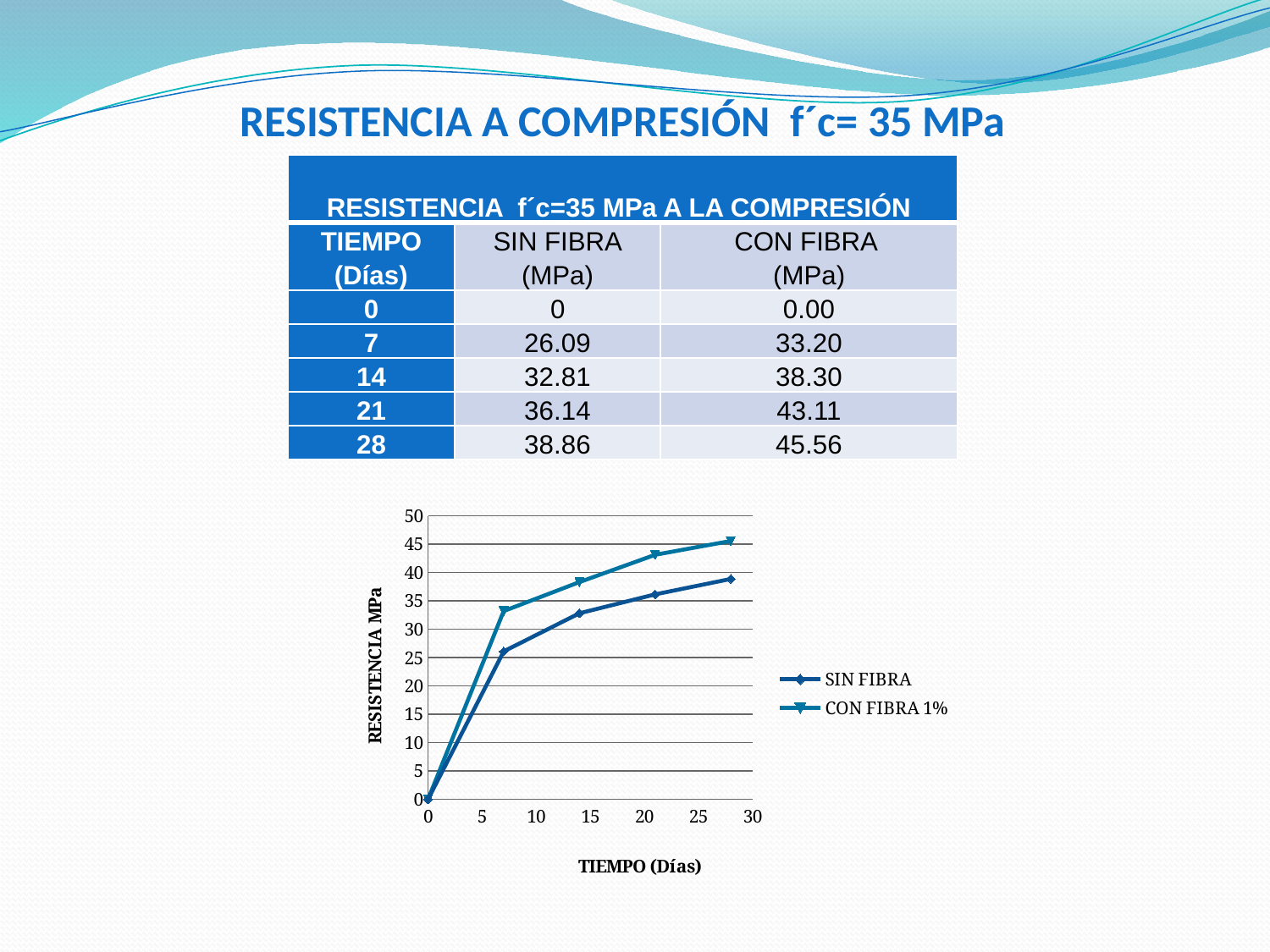
How many data points are plotted for each series in the chart? 5 Is the CON FIBRA 1% value at 28 days greater or less than 40? greater What are the two series named in the chart legend? SIN FIBRA and CON FIBRA 1% Is the SIN FIBRA value at 7 days greater or less than 30? less Using the table values, what is the difference between the CON FIBRA and SIN FIBRA resistance at 28 days? 6.70 According to the table, what is the CON FIBRA resistance at 21 days? 43.11 What kind of chart is shown on the slide? line chart At 28 days, which series has the higher resistance, SIN FIBRA or CON FIBRA 1%? CON FIBRA 1% How many series does the chart legend list? 2 Do the values of the SIN FIBRA series rise or fall as time (días) increases? rise According to the table, what is the SIN FIBRA resistance at 28 days? 38.86 What is the title of the chart's vertical axis? RESISTENCIA MPa